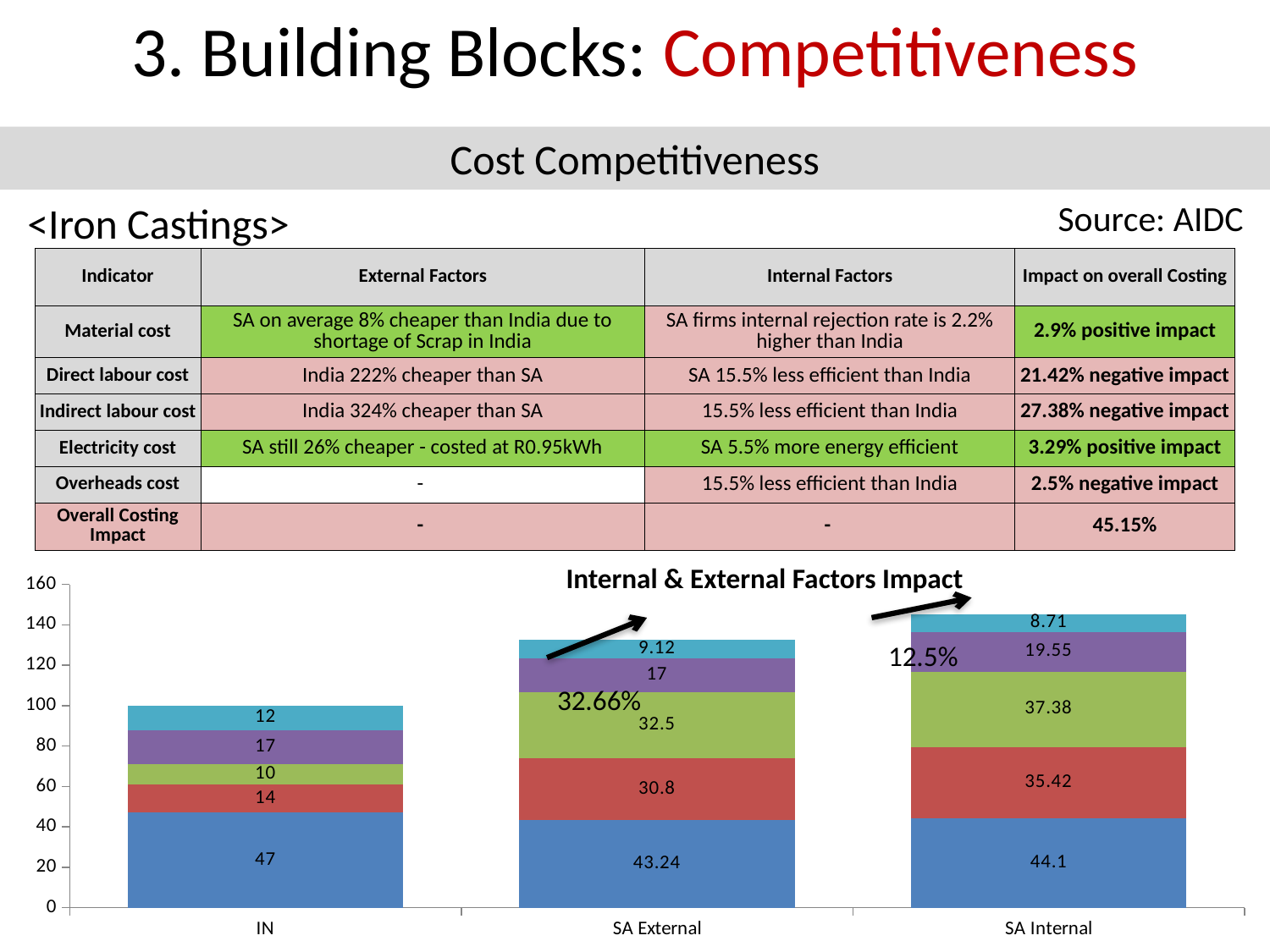
What is the value of the top (light blue) segment of the SA External bar? 9.12 What type of chart is shown at the bottom of the slide? Stacked bar chart Which category has the tallest stacked bar? SA Internal What is the value of the bottom (blue) segment of the SA External bar? 43.24 What is the difference between the red segment of SA Internal (35.42) and the red segment of SA External (30.8)? 4.62 What is the value of the green segment of the SA Internal bar? 37.38 What is the total of the stacked bar for IN? 100 What is the value of the bottom (blue) segment of the IN bar? 47 Is the total height of the SA Internal bar greater or less than 140? greater What is the title of the chart at the bottom of the slide? Internal & External Factors Impact Which category has the shortest stacked bar? IN How many categories are shown on the x axis of the chart? 3